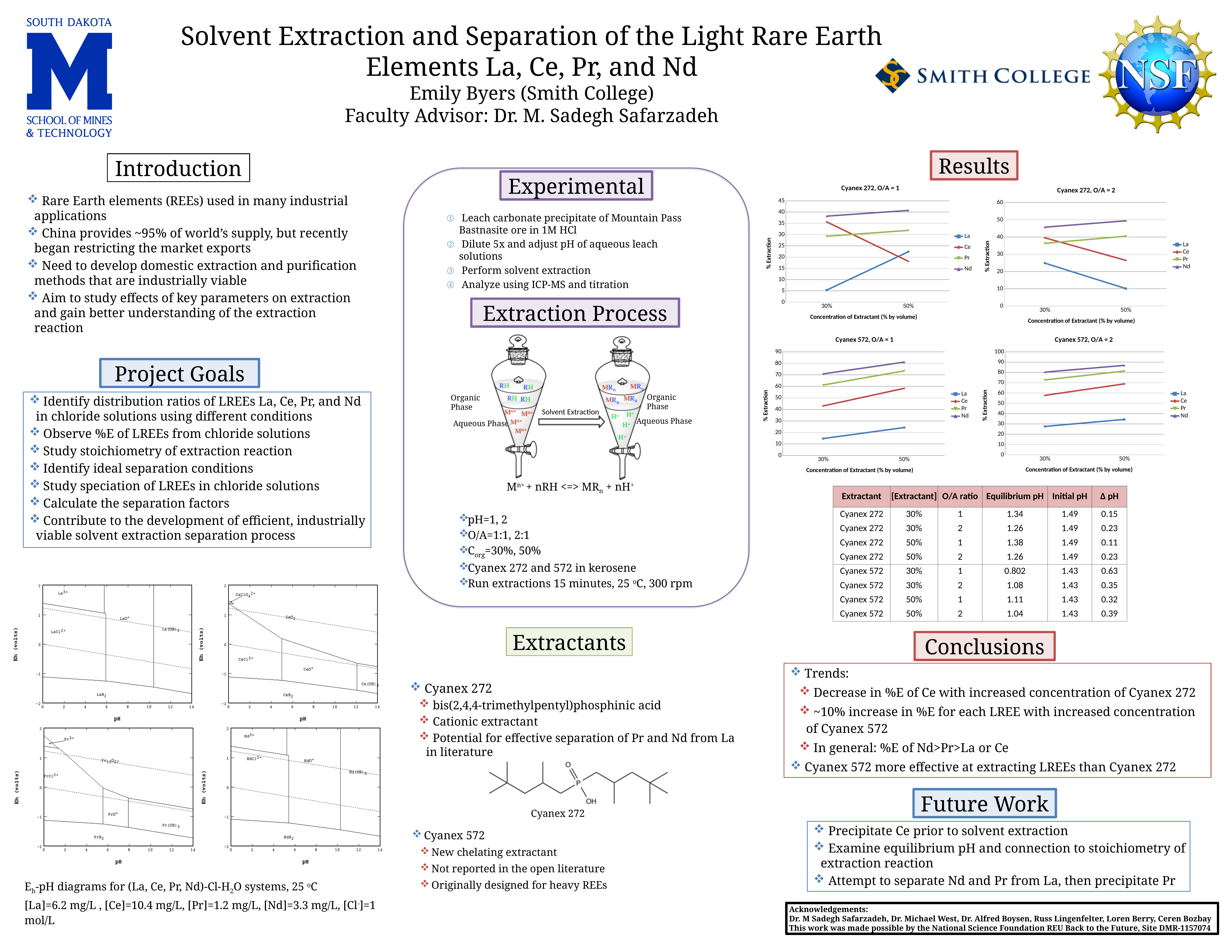
In "Cyanex 272, O/A = 1", which element has the highest % extraction at 30%? Nd How many concentration values are shown on the x axis of "Cyanex 272, O/A = 2"? 2 In "Cyanex 272, O/A = 1", does the % extraction of Ce rise or fall from 30% to 50%? fall In "Cyanex 272, O/A = 1", is the % extraction of La at 30% greater or less than 10? less How many series does the legend of "Cyanex 572, O/A = 2" list? 4 What is the x-axis title of "Cyanex 572, O/A = 2"? Concentration of Extractant (% by volume) In "Cyanex 272, O/A = 2", at 50% concentration, which is larger: the % extraction of Pr or of Ce? Pr In "Cyanex 272, O/A = 2", does the % extraction of La rise or fall from 30% to 50%? fall In "Cyanex 572, O/A = 1", is the % extraction of Nd at 30% greater or less than 60? greater What kind of chart is "Cyanex 272, O/A = 1"? line chart In "Cyanex 272, O/A = 1", which element has the lowest % extraction at 30%? La In "Cyanex 272, O/A = 2", which element has the lowest % extraction at 50%? La